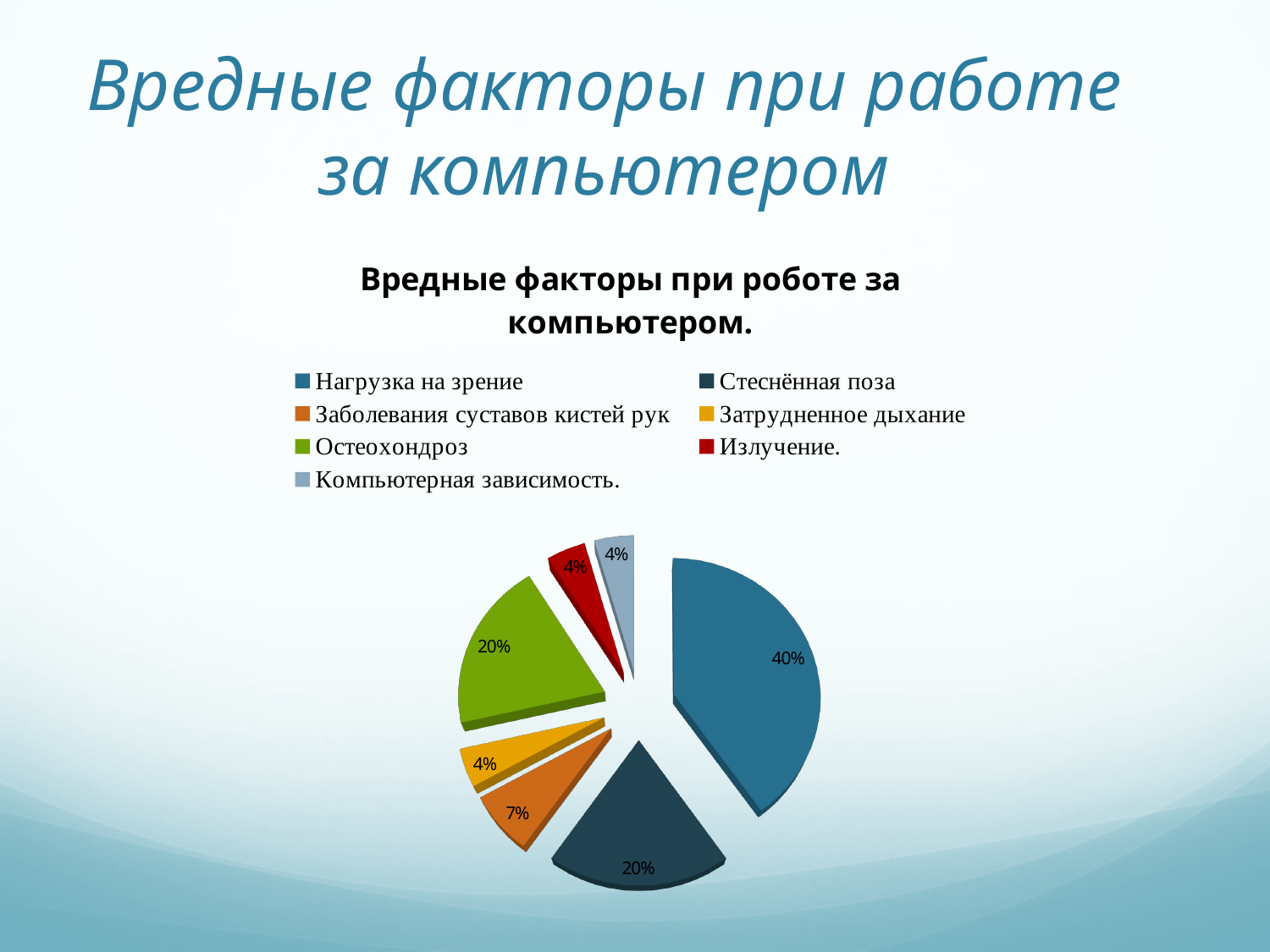
What is the title of the chart? Вредные факторы при роботе за компьютером. What percentage does the pie chart show for Стеснённая поза? 20% What percentage does the pie chart show for Заболевания суставов кистей рук? 7% What percentage does the pie chart show for Остеохондроз? 20% What kind of chart is shown on the slide? Pie chart What is the difference in percentage points between Нагрузка на зрение and Стеснённая поза? 20 What percentage does the pie chart show for Нагрузка на зрение? 40% What percentage does the pie chart show for Излучение? 4% Which category has the largest slice of the pie chart? Нагрузка на зрение How many slices does the pie chart have? 7 Which is larger in the pie chart: Остеохондроз or Заболевания суставов кистей рук? Остеохондроз What colour is the slice for Излучение in the pie chart? Red